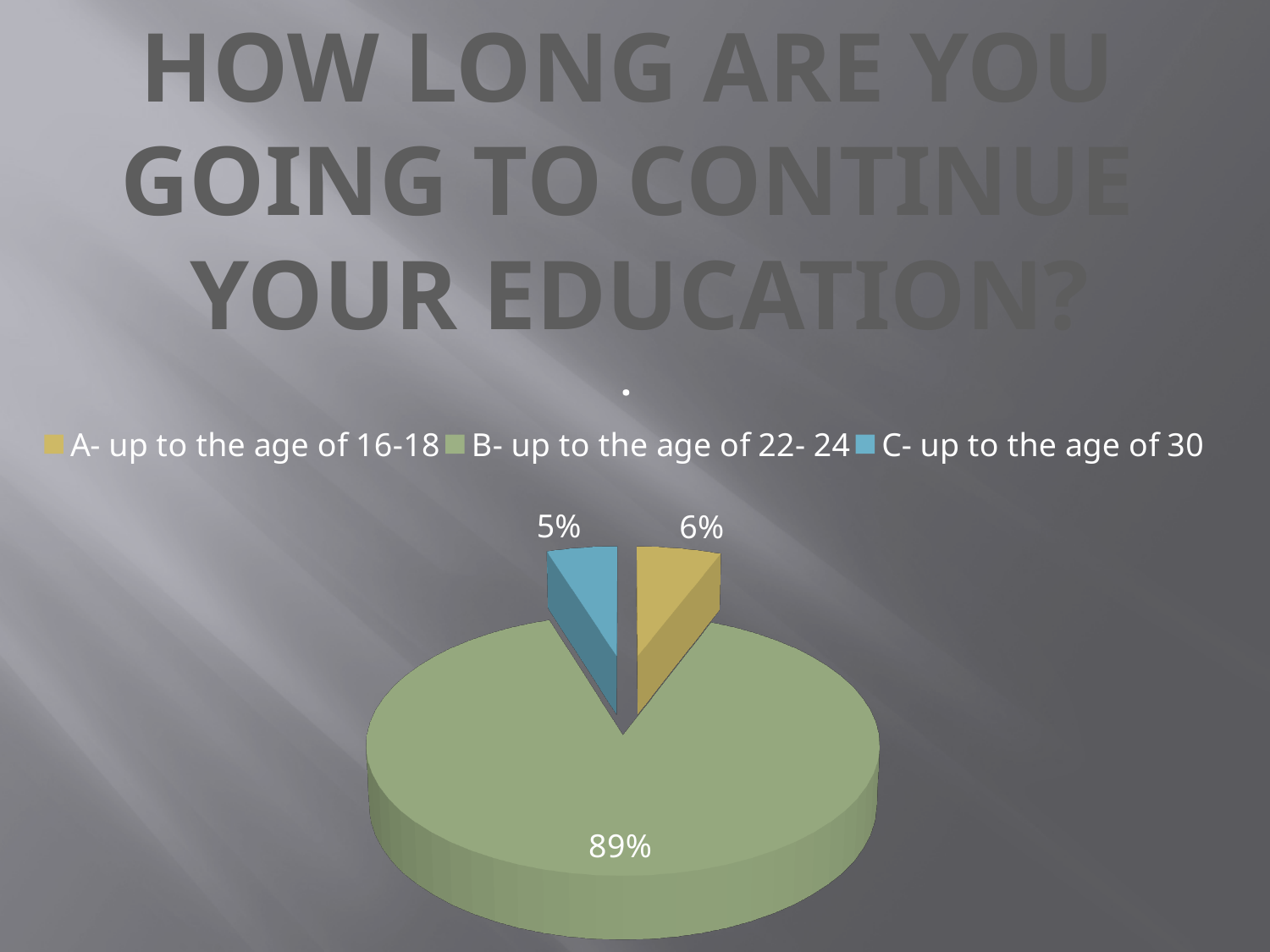
Which is larger, the slice for "A- up to the age of 16-18" or the slice for "C- up to the age of 30"? A- up to the age of 16-18 How many slices does the pie chart have? 3 What share of the pie does "C- up to the age of 30" have? 5% How many entries does the legend list? 3 Which category has the smallest slice of the pie? C- up to the age of 30 What is the difference in percentage points between the slice for "B- up to the age of 22- 24" and the slice for "A- up to the age of 16-18"? 83 What kind of chart is shown on the slide? pie chart Which category has the largest slice of the pie? B- up to the age of 22- 24 What question does the slide title ask? HOW LONG ARE YOU GOING TO CONTINUE YOUR EDUCATION? What share of the pie does "A- up to the age of 16-18" have? 6% What colour is the slice for "C- up to the age of 30"? blue What share of the pie does "B- up to the age of 22- 24" have? 89%